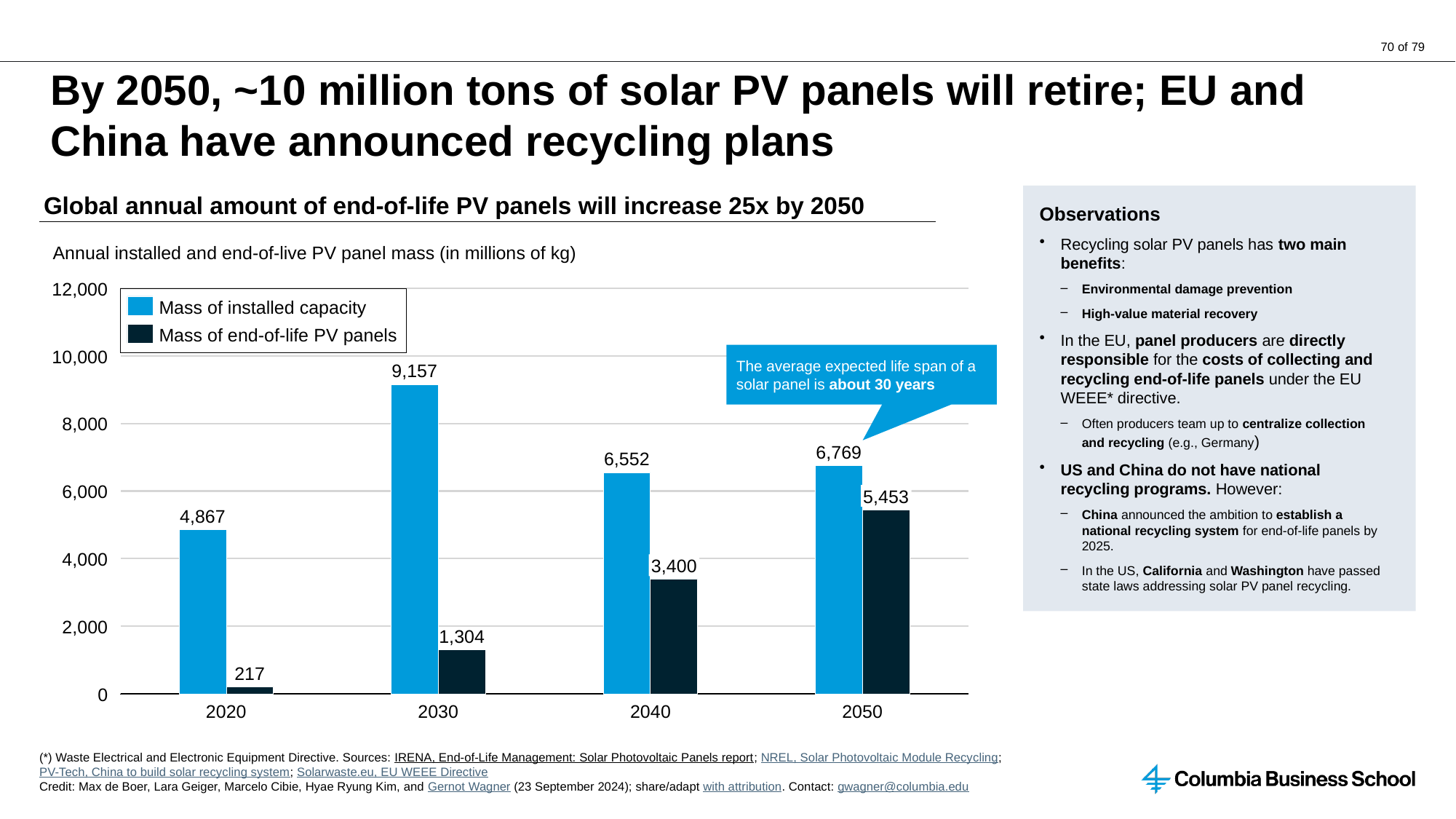
Which year has the lowest mass of end-of-life PV panels? 2020 Which is larger in 2050: the mass of installed capacity or the mass of end-of-life PV panels? Mass of installed capacity What is the difference between the mass of installed capacity and the mass of end-of-life PV panels in 2040? 3,152 Does the mass of end-of-life PV panels rise or fall from 2020 to 2050? Rise How many years are shown on the x axis? 4 Is the mass of end-of-life PV panels in 2030 greater or less than 2,000? less How many series does the legend list? 2 Which year has the highest mass of installed capacity? 2030 What is the mass of installed capacity in 2030? 9,157 What kind of chart is shown? Bar chart What is the mass of end-of-life PV panels in 2020? 217 What is the mass of end-of-life PV panels in 2050? 5,453